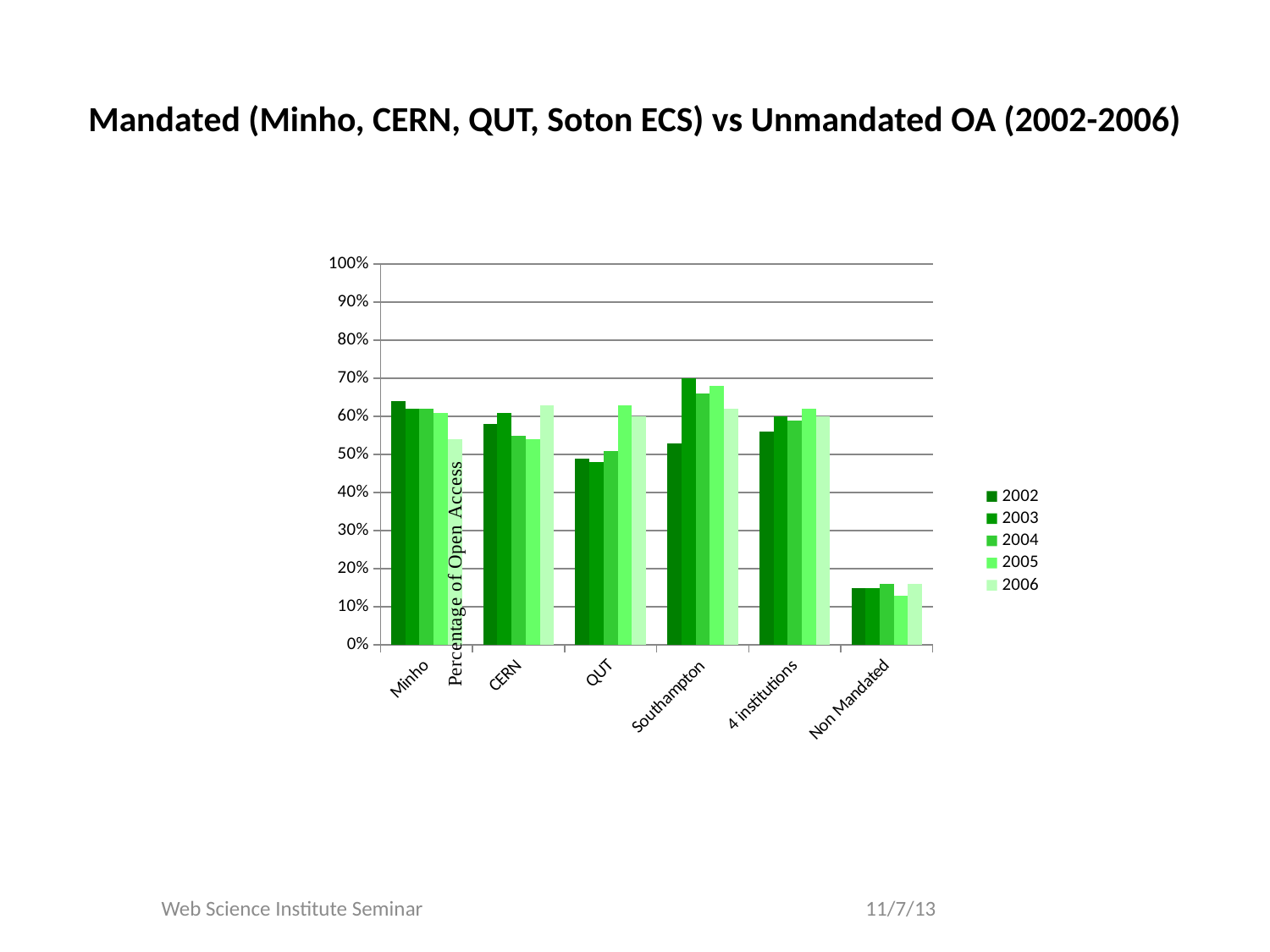
Is the value for Minho in 2002 greater or less than 60%? greater Which category has the lowest values across all years? Non Mandated How many categories are shown along the x axis? 6 Which is larger, the 2003 value for Southampton or the 2003 value for Non Mandated? Southampton Is the value for Non Mandated in 2002 greater or less than 20%? less What is the label on the vertical axis? Percentage of Open Access How many series does the legend list? 5 What kind of chart is shown on the slide? bar chart Which is larger, the 2002 value for Minho or the 2002 value for QUT? Minho Is the value for Southampton in 2003 greater or less than 60%? greater Which category contains the single tallest bar in the chart? Southampton